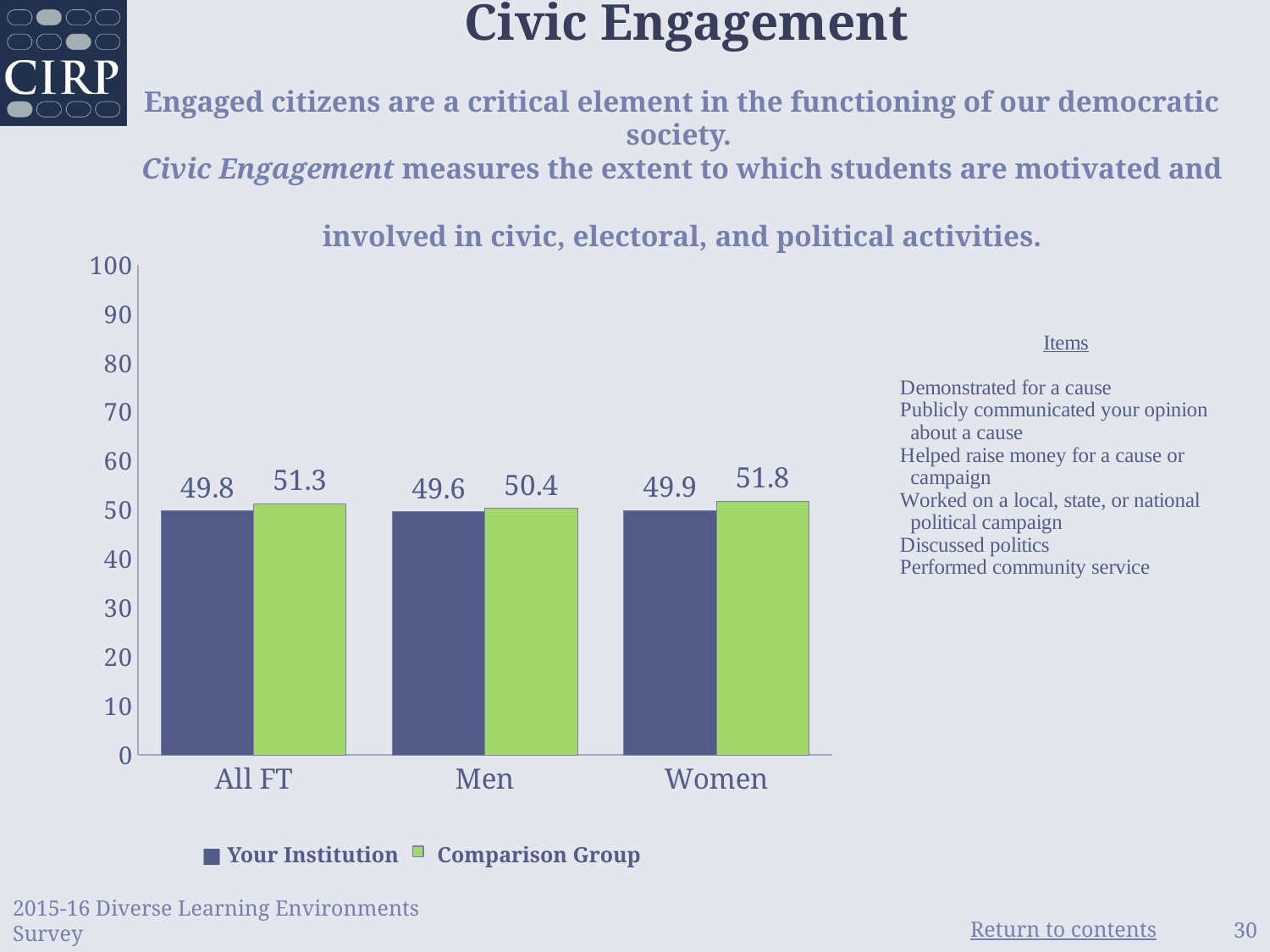
How many categories are shown on the x axis? 3 What is the value for Your Institution in the All FT category? 49.8 What is the difference between the Comparison Group and Your Institution values for Women? 1.9 What is the value for Your Institution in the Men category? 49.6 What is the difference between the Comparison Group and Your Institution values for All FT? 1.5 Which category has the lowest Your Institution value? Men Which is larger for Men: Your Institution or Comparison Group? Comparison Group How many series does the legend list? 2 What is the value for Comparison Group in the Women category? 51.8 What kind of chart is shown on the slide? Bar chart What is the value for Comparison Group in the Men category? 50.4 Which category has the highest Comparison Group value? Women